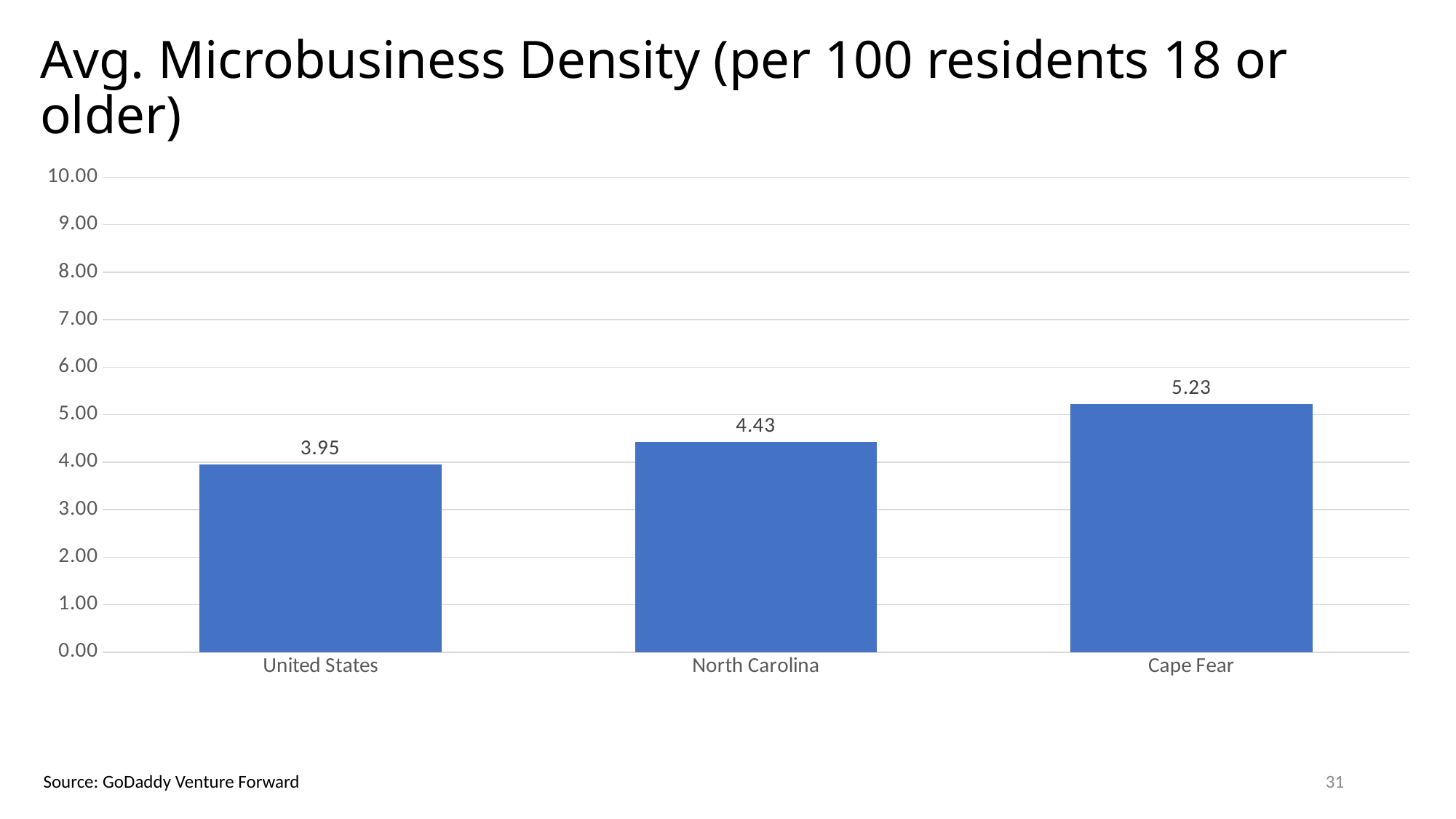
What is the average microbusiness density for North Carolina? 4.43 Which category has the highest average microbusiness density? Cape Fear What kind of chart is shown on the slide? Bar chart What is the average microbusiness density for the United States? 3.95 What is the difference between the North Carolina and United States values? 0.48 How many categories are shown in the chart? 3 Is the value for Cape Fear greater or less than 5.00? greater Do the values rise or fall from left to right across the categories? Rise Which is larger, the value for North Carolina or the value for Cape Fear? Cape Fear What is the average microbusiness density for Cape Fear? 5.23 Which category has the lowest average microbusiness density? United States What is the difference between the Cape Fear and United States values? 1.28